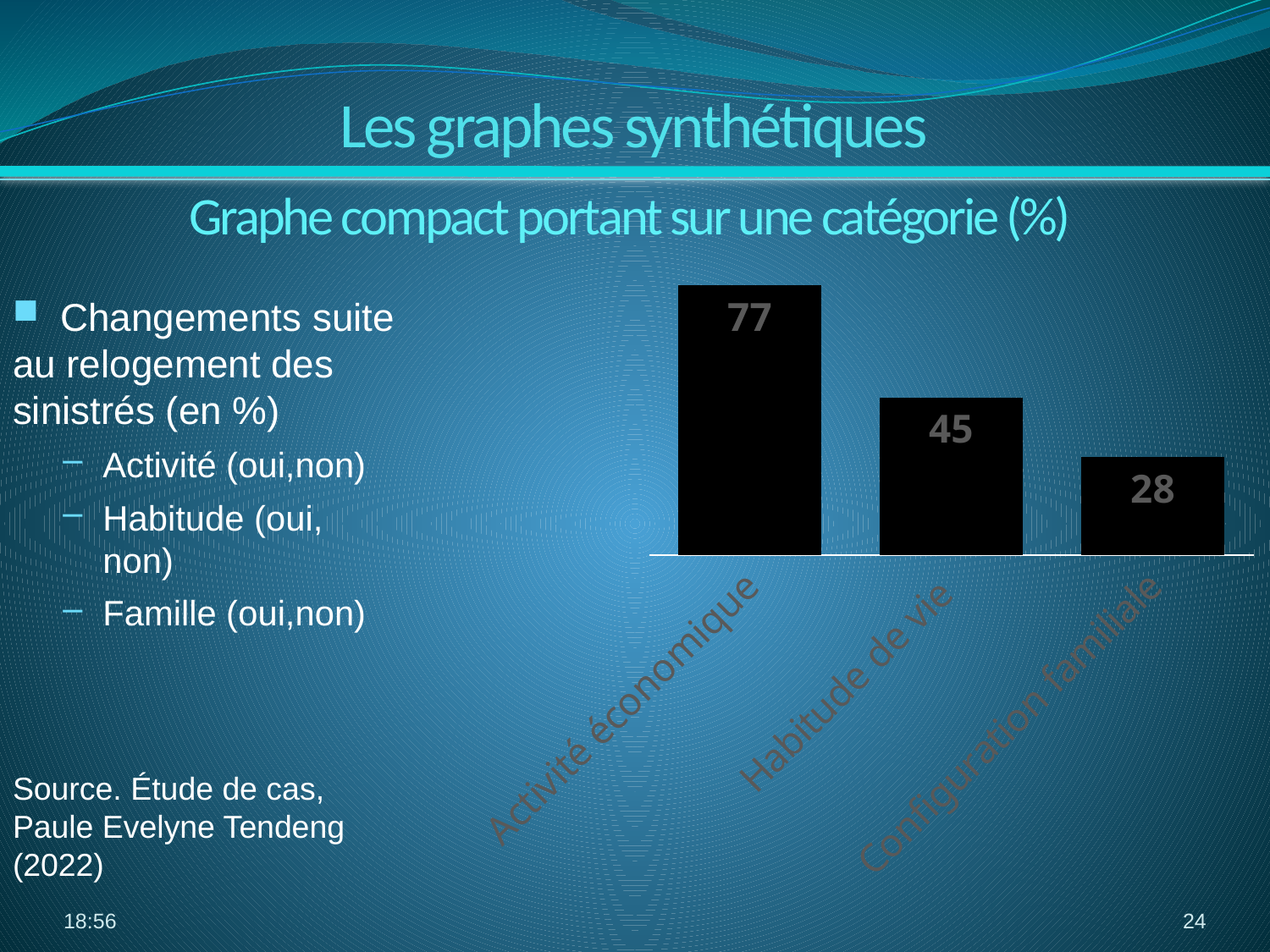
Which is larger, the value for Habitude de vie or the value for Configuration familiale? Habitude de vie What is the value for Activité économique? 77 Do the values rise or fall from left to right across the categories? fall What is the difference between the values for Habitude de vie and Configuration familiale? 17 What is the value for Configuration familiale? 28 Which category has the highest value? Activité économique What is the value for Habitude de vie? 45 Which category has the lowest value? Configuration familiale How many categories are shown in the chart? 3 What kind of chart is shown on the slide? bar chart What colour are the bars in the chart? black What is the difference between the values for Activité économique and Habitude de vie? 32